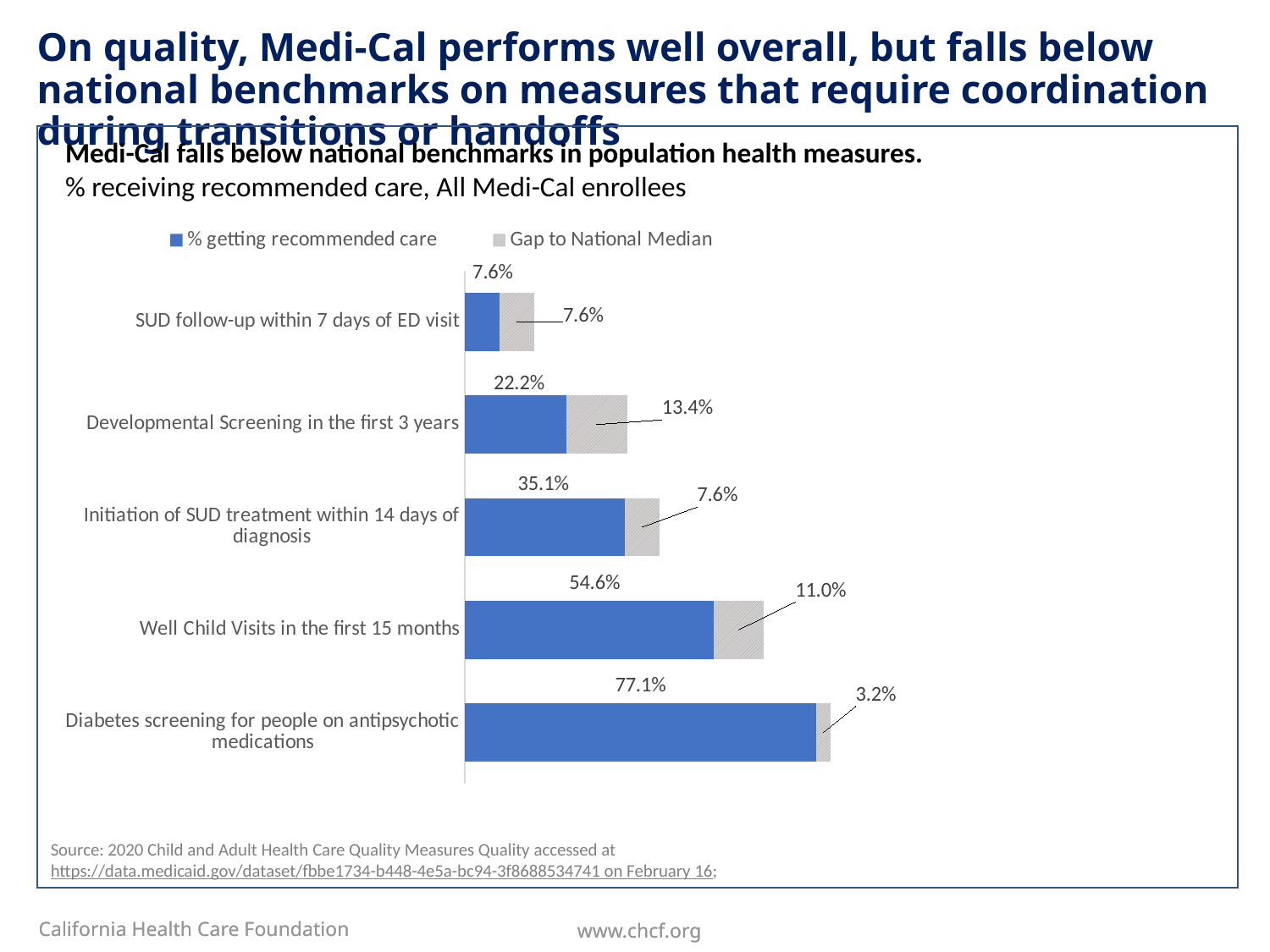
Which measure has the highest % getting recommended care? Diabetes screening for people on antipsychotic medications How many measures are shown in the chart? 5 What is the % getting recommended care for SUD follow-up within 7 days of ED visit? 7.6% Which has a larger Gap to National Median: Well Child Visits in the first 15 months or Initiation of SUD treatment within 14 days of diagnosis? Well Child Visits in the first 15 months What percentage of Medi-Cal enrollees are getting recommended care for Well Child Visits in the first 15 months? 54.6% What is the total of the stacked bar for Developmental Screening in the first 3 years (% getting recommended care plus Gap to National Median)? 35.6% What is the Gap to National Median for Developmental Screening in the first 3 years? 13.4% What type of chart is shown on the slide? Stacked bar chart Which measure has the smallest Gap to National Median? Diabetes screening for people on antipsychotic medications What is the difference in % getting recommended care between Diabetes screening for people on antipsychotic medications and Well Child Visits in the first 15 months? 22.5% How many series does the legend list? 2 Which measure has the lowest % getting recommended care? SUD follow-up within 7 days of ED visit